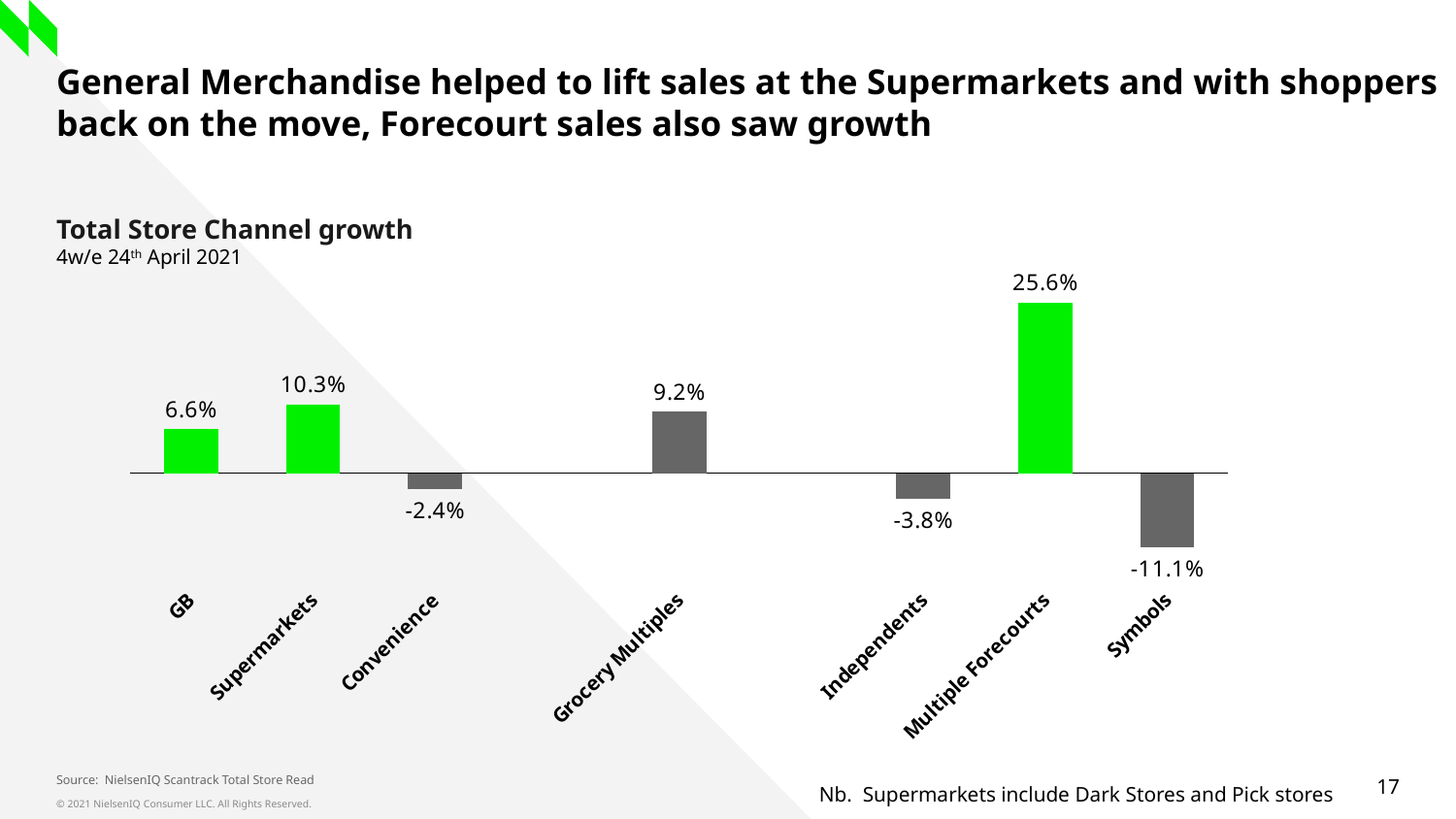
What is the growth value for Supermarkets? 10.3% What is the difference between the growth for Multiple Forecourts and Grocery Multiples? 16.4% Which channel has the highest growth? Multiple Forecourts How many channels are shown in the chart? 7 What is the growth value for Multiple Forecourts? 25.6% Which channel has the lowest growth? Symbols What is the growth value for Convenience? -2.4% What is the title of the chart? Total Store Channel growth Which has the larger growth, Grocery Multiples or GB? Grocery Multiples What type of chart is shown on the slide? Bar chart What is the growth value for Symbols? -11.1% What is the difference between the growth for Supermarkets and GB? 3.7%